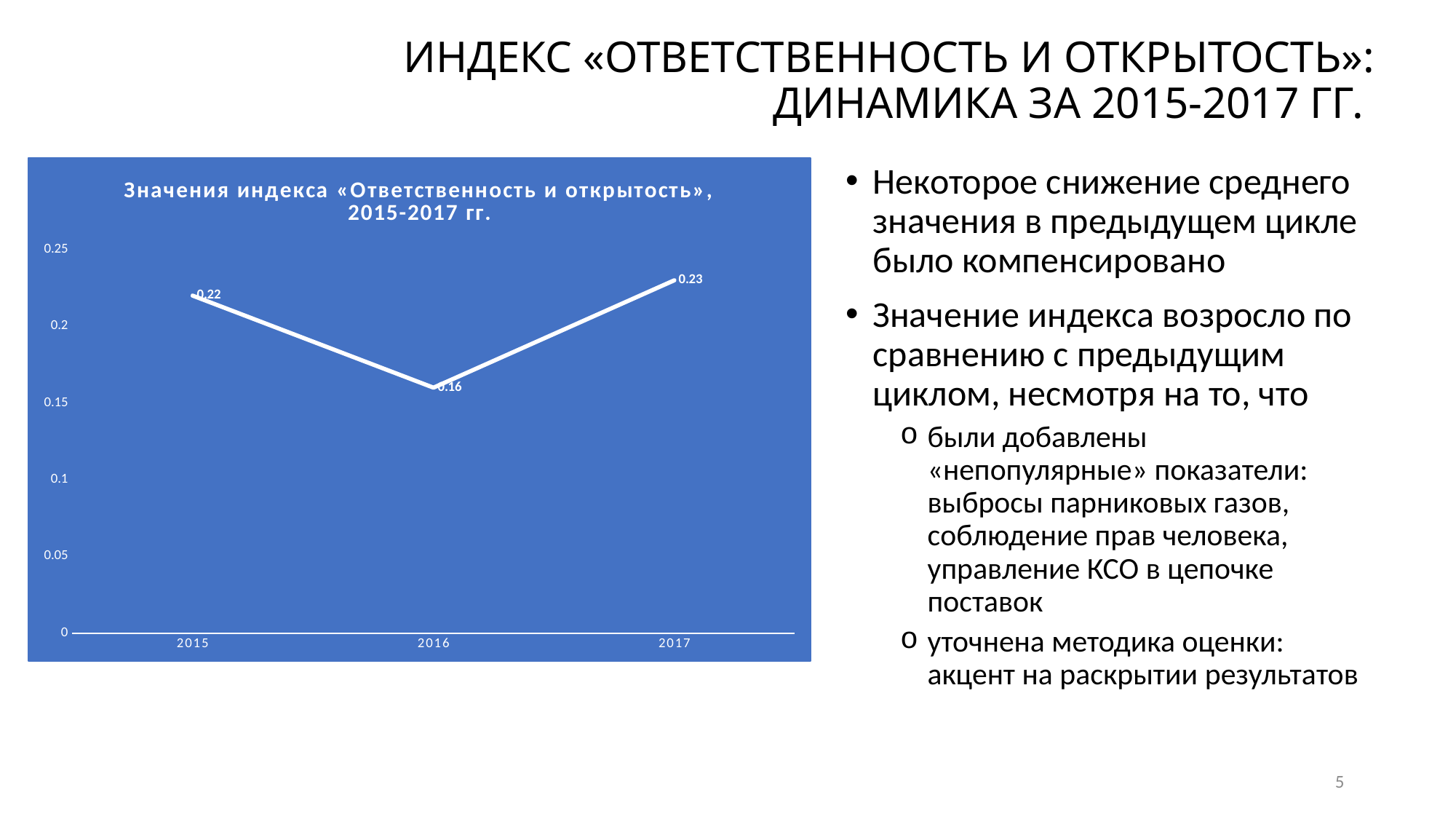
What is the index value for 2016? 0.16 What is the index value for 2015? 0.22 Which year has a larger index value, 2015 or 2016? 2015 What is the difference between the index values for 2017 and 2016? 0.07 What is the index value for 2017? 0.23 Which year has the highest index value? 2017 Is the index value for 2016 greater or less than 0.2? less What kind of chart is shown on the slide? line chart What is the difference between the index values for 2015 and 2016? 0.06 How many years are plotted on the chart? 3 What is the title of the chart? Значения индекса «Ответственность и открытость», 2015-2017 гг. Which year has the lowest index value? 2016